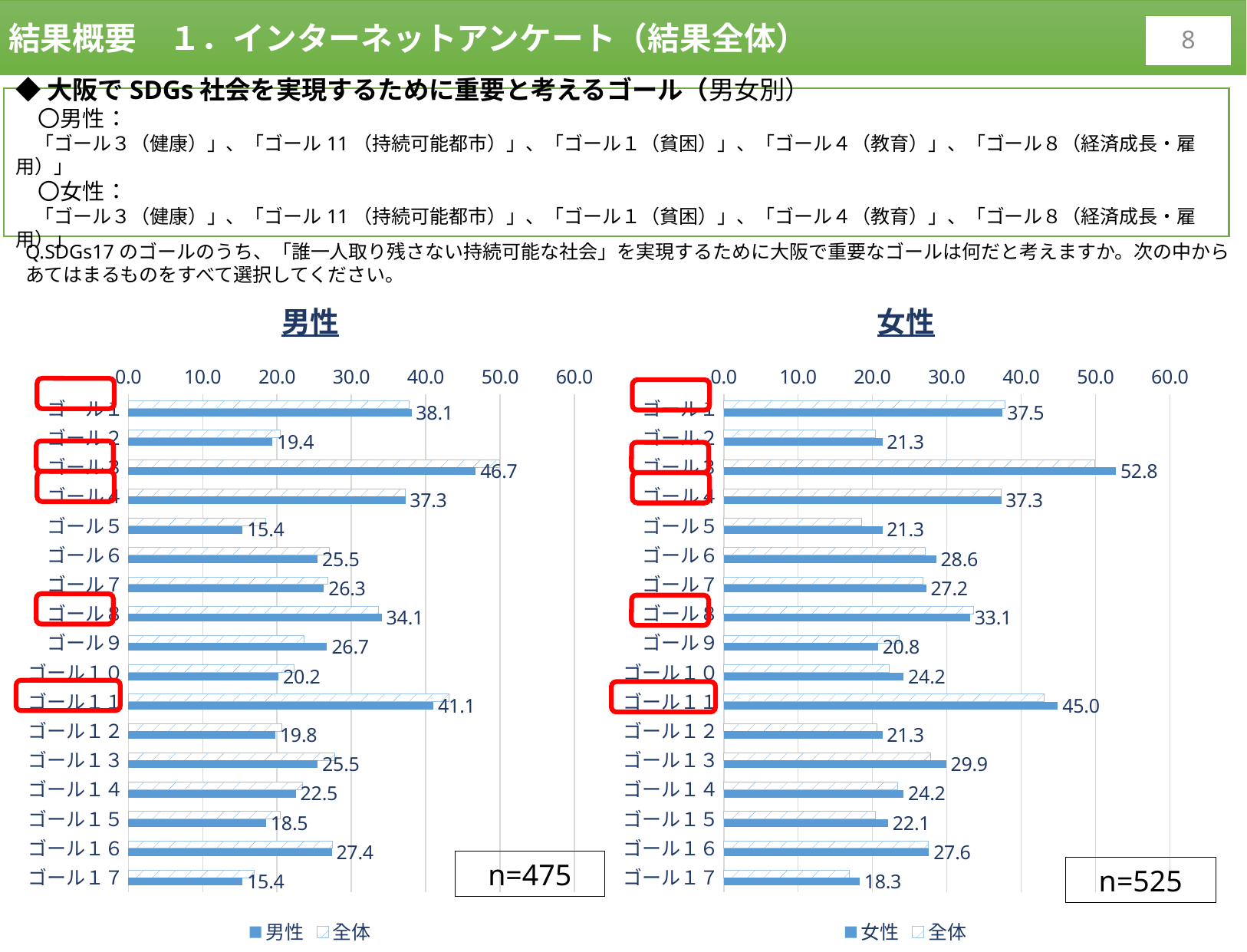
In the 女性 chart, which goal has the lowest value? ゴール１７ How many goal categories are shown in the 男性 chart? 17 In the 男性 chart, what is the value for ゴール３? 46.7 In the 女性 chart, which goal has the highest value? ゴール３ In the 男性 chart, what is the difference between ゴール３ and ゴール１１? 5.6 In the 男性 chart, which goal has the lowest value? ゴール５ and ゴール１７ (15.4) What kind of chart is the 男性 chart? Bar chart In the 女性 chart, what is the value for ゴール１１? 45.0 In the 女性 chart, what is the difference between ゴール３ and ゴール１? 15.3 In the 女性 chart, is the value for ゴール３ greater or less than 50.0? greater In the 男性 chart, which is larger, ゴール１ or ゴール４? ゴール１ How many series does the legend of the 女性 chart list? 2